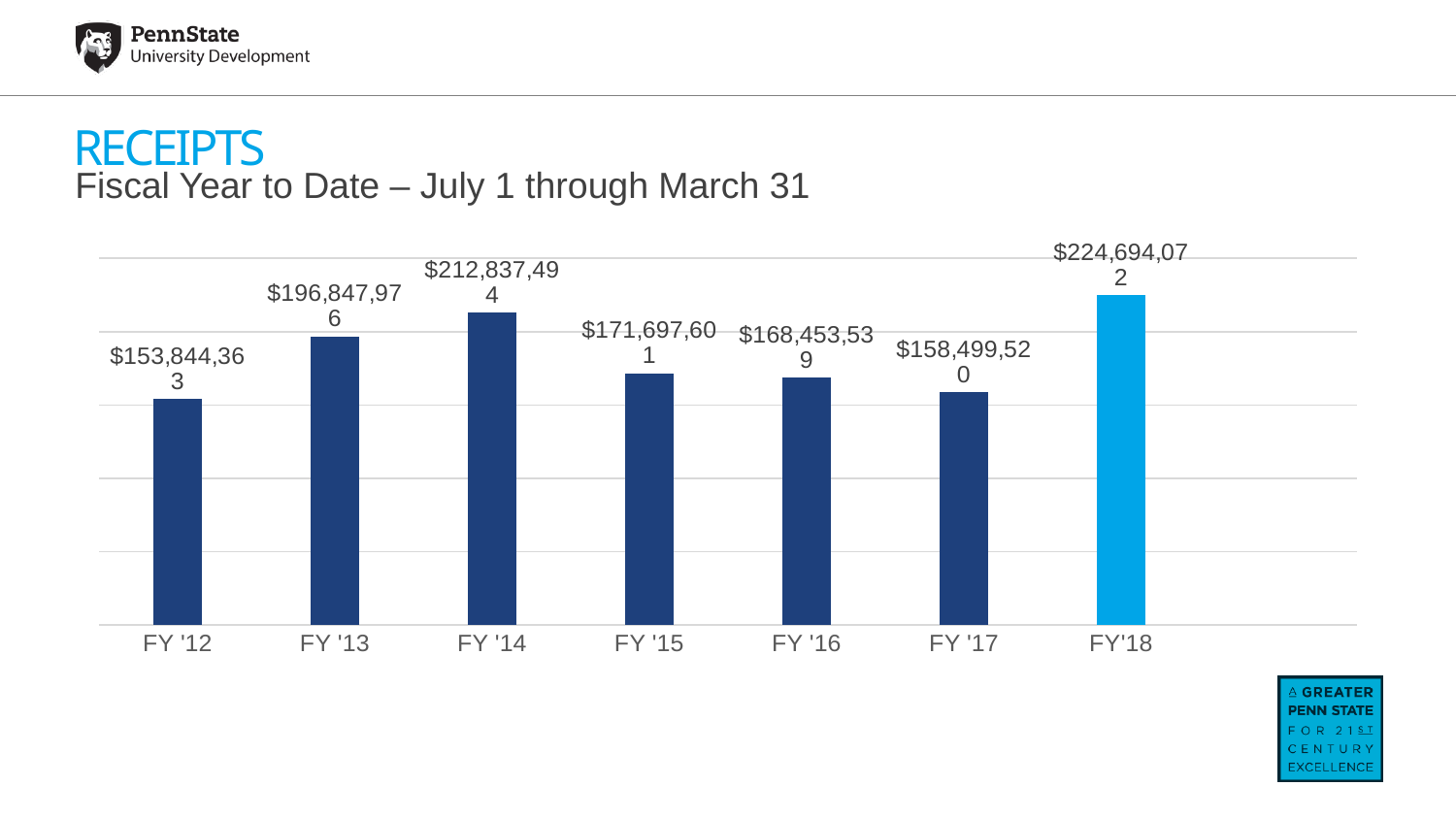
What is the difference between the FY'18 and FY '14 values? $11,856,578 What is the difference between the FY '13 and FY '12 values? $43,003,613 Which fiscal year has the highest receipts? FY'18 What kind of chart is shown on the slide? Bar chart Do the values rise or fall from FY '14 to FY '17? Fall What is the value for FY'18? $224,694,072 Which is larger, the value for FY '15 or FY '17? FY '15 Which fiscal year has the lowest receipts? FY '12 What is the value for FY '12? $153,844,363 How many fiscal years are shown on the chart? 7 What is the value for FY '16? $168,453,539 What is the value for FY '14? $212,837,494